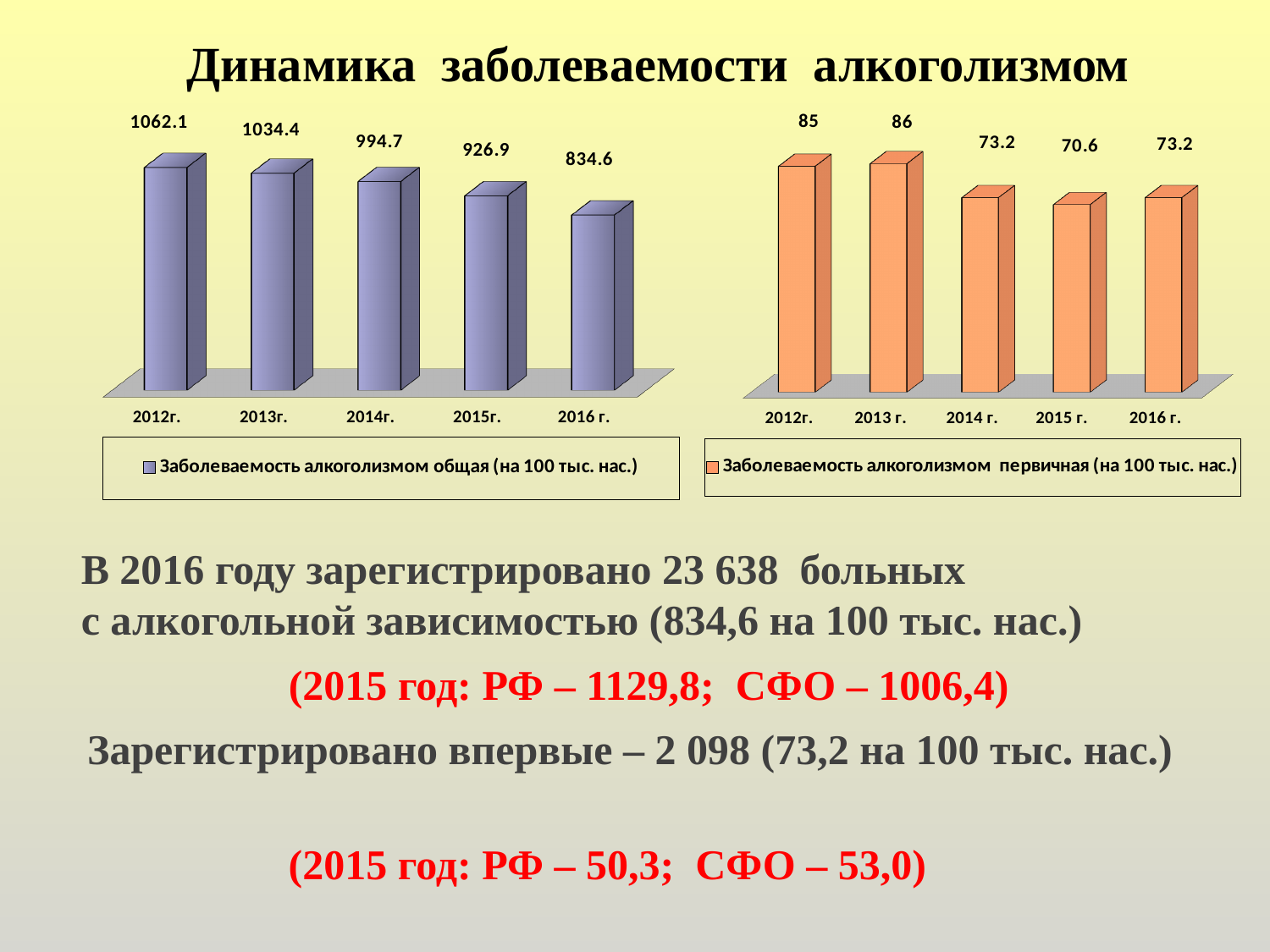
In the left chart (Заболеваемость алкоголизмом общая), which is larger: the value for 2013г. or the value for 2015г.? 2013г. In the left chart (Заболеваемость алкоголизмом общая), what is the value for 2016 г.? 834.6 How many years are shown in the left chart (Заболеваемость алкоголизмом общая)? 5 In the right chart (Заболеваемость алкоголизмом первичная), which year has the lowest value? 2015 г. In the right chart (Заболеваемость алкоголизмом первичная), what is the difference between the values for 2013 г. and 2015 г.? 15.4 In the left chart (Заболеваемость алкоголизмом общая), what is the difference between the values for 2012г. and 2016 г.? 227.5 In the left chart (Заболеваемость алкоголизмом общая), do the values rise or fall from 2012г. to 2016 г.? fall In the left chart (Заболеваемость алкоголизмом общая), what is the value for 2014г.? 994.7 What kind of chart is the right chart (Заболеваемость алкоголизмом первичная)? bar chart In the right chart (Заболеваемость алкоголизмом первичная), which year has the highest value? 2013 г. In the left chart (Заболеваемость алкоголизмом общая), which year has the lowest value? 2016 г. In the right chart (Заболеваемость алкоголизмом первичная), what is the value for 2015 г.? 70.6